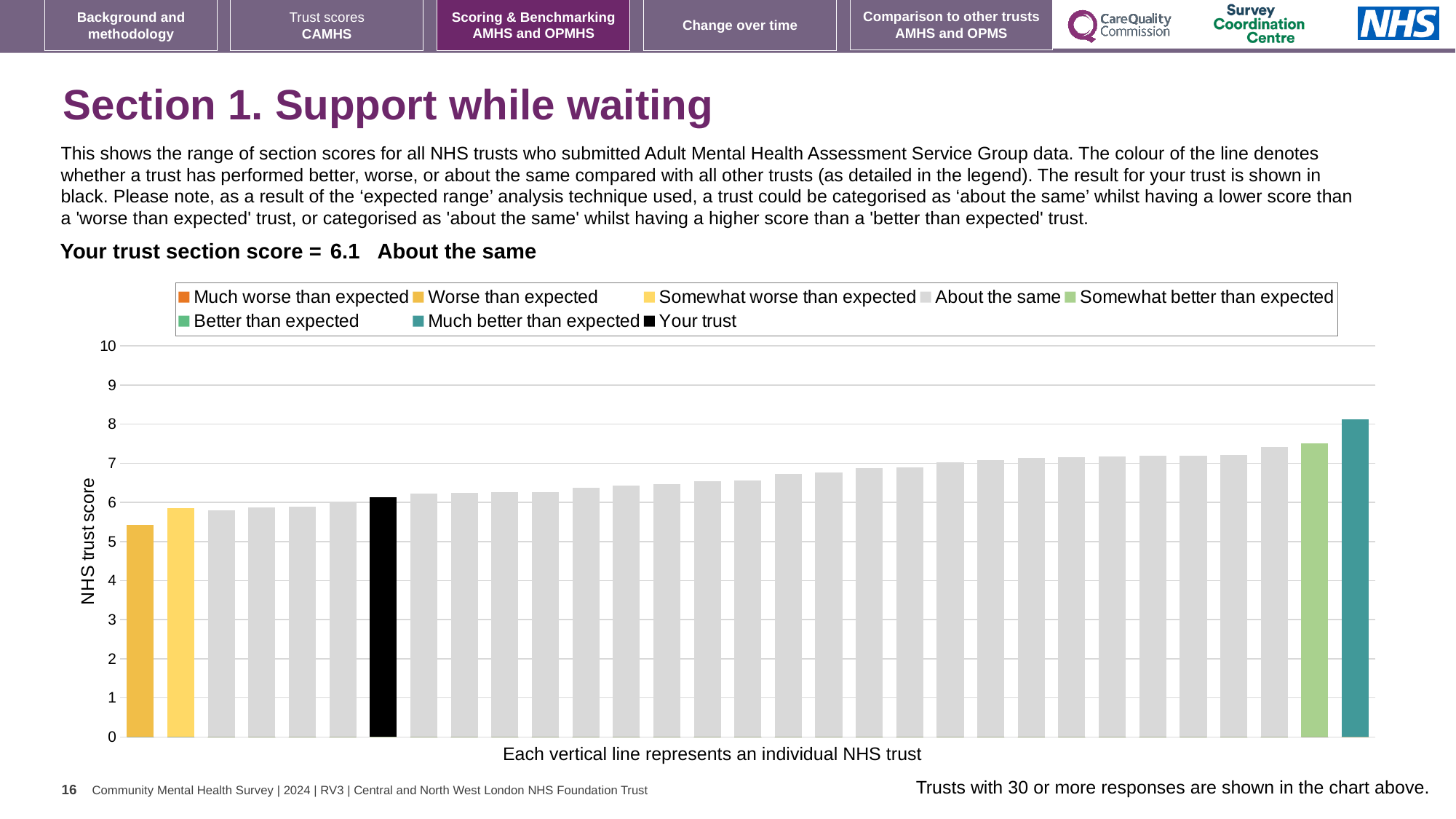
How many entries does the chart legend list? 8 What kind of chart is shown on the slide? bar chart Is the value for your trust (black bar) greater or less than 7? less Is the value of the shortest bar (Worse than expected) greater or less than 6? less Which legend category does the shortest bar in the chart belong to? Worse than expected Which is larger: the value for your trust or the value of the Much better than expected bar? Much better than expected What is the section score for your trust shown on the slide? 6.1 Which legend category does the tallest bar in the chart belong to? Much better than expected Do the bar values rise or fall from left to right along the x axis? rise Is the value of the tallest bar (Much better than expected) greater or less than 7? greater What is the label on the vertical axis of the chart? NHS trust score How is your trust's score categorised compared with other trusts? About the same